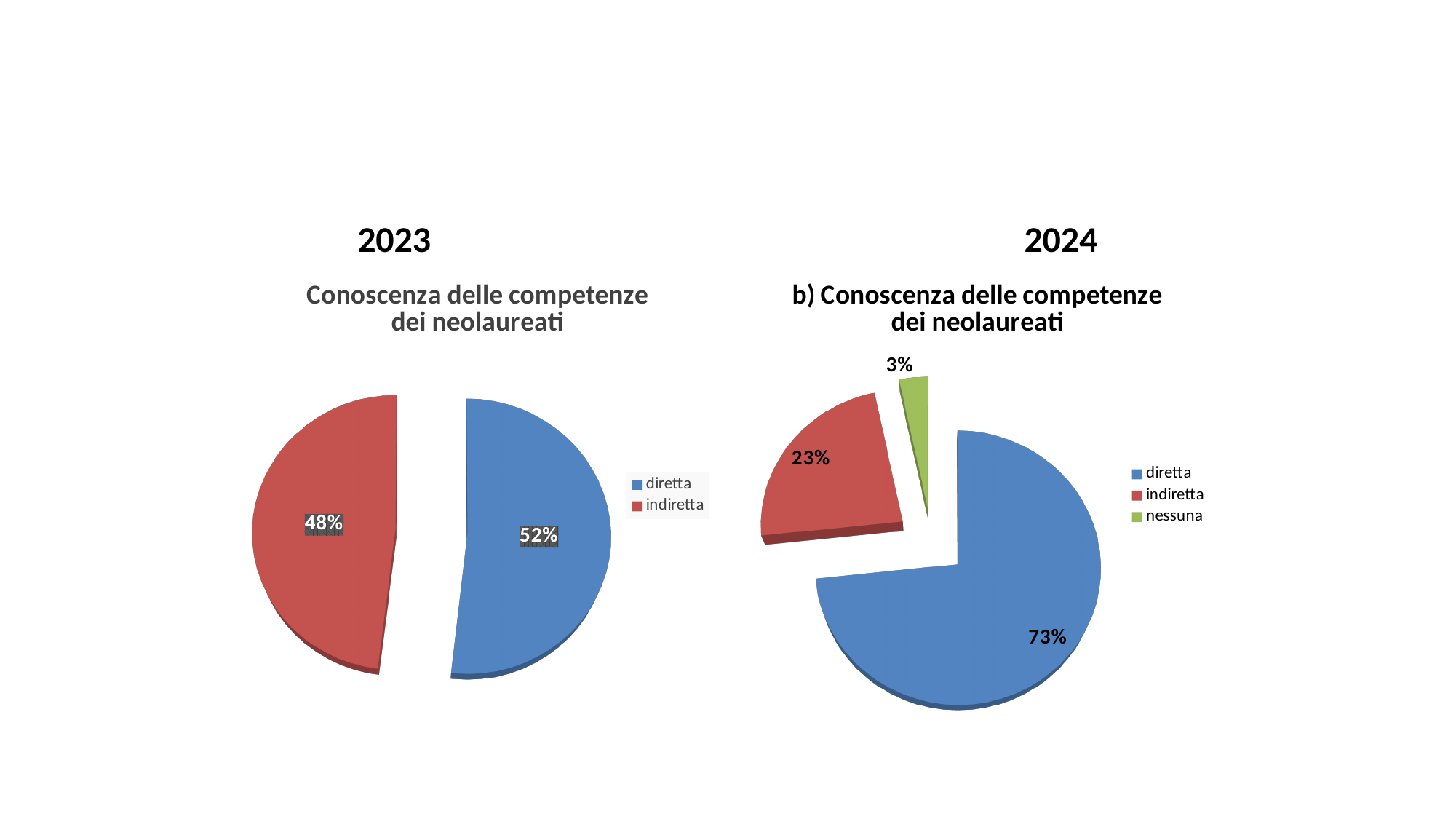
In the 2024 chart, which category has the largest slice? diretta What kind of chart is the 2023 chart? pie chart In the 2023 chart, which is larger, 'diretta' or 'indiretta'? diretta In the 2024 chart, what share of the pie is 'indiretta'? 23% In the 2024 chart, what share of the pie is 'nessuna'? 3% In the 2024 chart, what share of the pie is 'diretta'? 73% In the 2023 chart, what share of the pie is 'diretta'? 52% In the 2024 chart, which category has the smallest slice? nessuna What is the title of the 2024 chart? b) Conoscenza delle competenze dei neolaureati In the 2024 chart, what is the difference between the 'diretta' and 'indiretta' shares? 50% How many categories does the legend of the 2024 chart list? 3 In the 2023 chart, what share of the pie is 'indiretta'? 48%